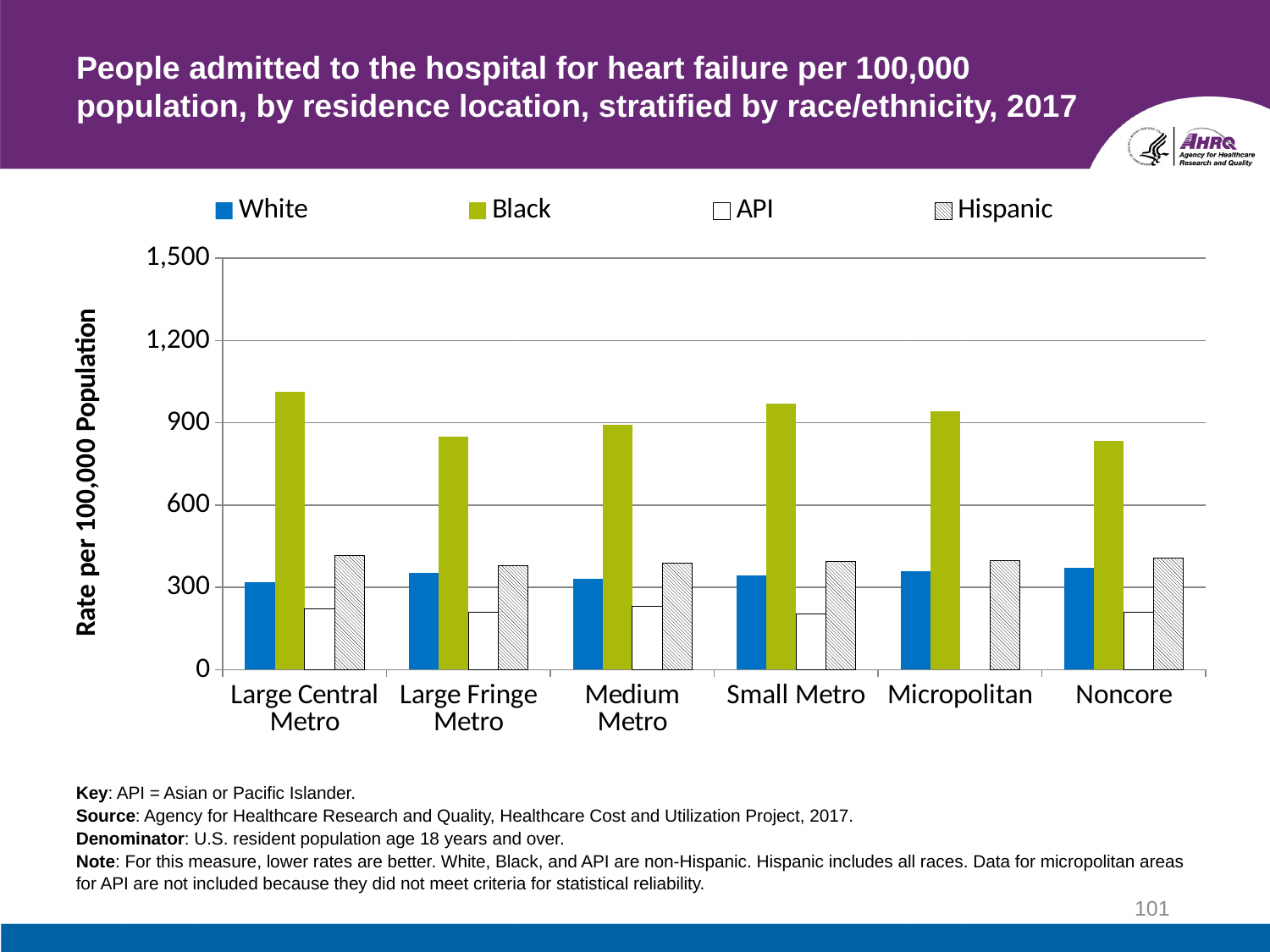
In Noncore, which is larger, the value for Hispanic or the value for White? Hispanic Is the value for White in Large Central Metro greater or less than 300? greater Which residence location has the highest rate for Black? Large Central Metro Is the value for Hispanic in Large Central Metro greater or less than 300? greater In Medium Metro, which is larger, the value for Black or the value for Hispanic? Black Is the value for API in Small Metro greater or less than 300? less What kind of chart is shown on the slide? Bar chart How many series does the legend list? 4 Which residence location has no bar for API? Micropolitan How many residence location categories are shown on the x axis? 6